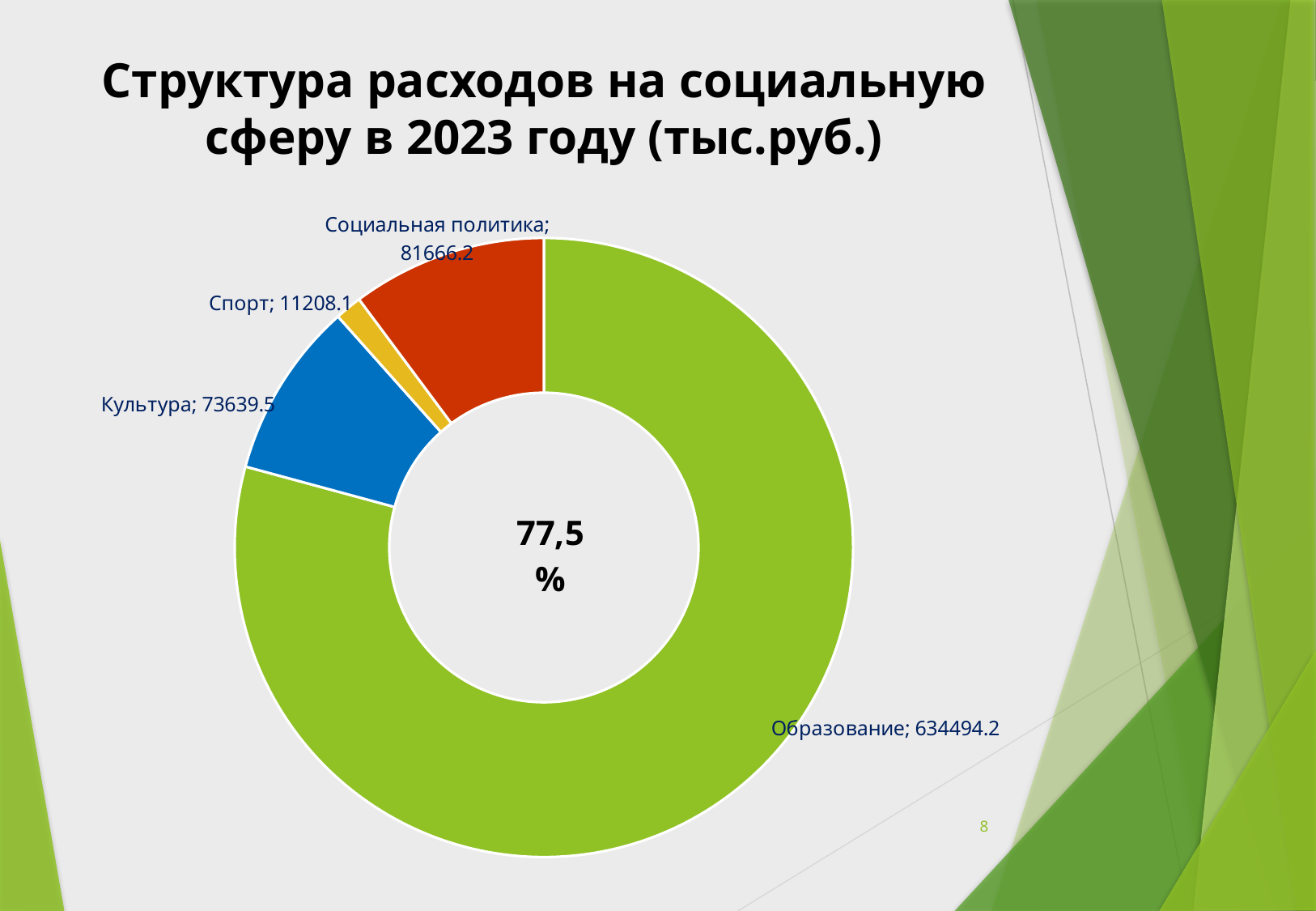
What is the value for Культура? 73639.5 How many categories are shown in the chart? 4 Which category has the smallest value? Спорт What kind of chart is shown on the slide? doughnut chart What is the difference between the values for Социальная политика and Культура? 8026.7 What is the difference between the values for Культура and Спорт? 62431.4 What is the value for Спорт? 11208.1 What percentage is printed in the centre of the chart? 77,5 % What is the value for Социальная политика? 81666.2 What is the value for Образование? 634494.2 Which category has the largest value? Образование Which is larger, the value for Социальная политика or the value for Культура? Социальная политика